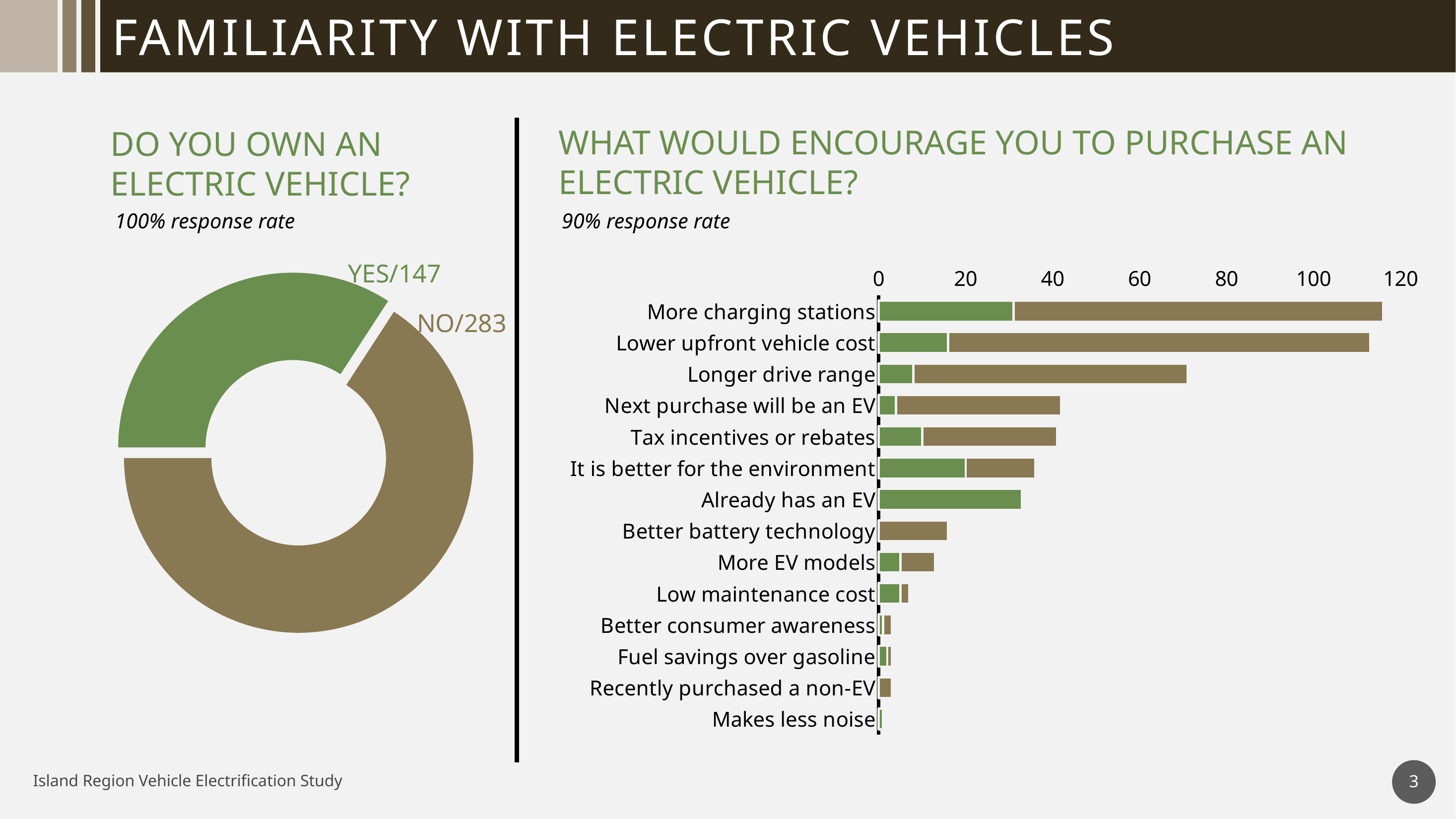
In the 'Do you own an electric vehicle?' chart, what is the difference between the NO and YES counts? 136 In the 'What would encourage you to purchase an electric vehicle?' chart, which bar is longer: 'More charging stations' or 'Longer drive range'? More charging stations What kind of chart is the 'Do you own an electric vehicle?' chart? Donut chart In the 'What would encourage you to purchase an electric vehicle?' chart, how many categories are listed? 14 In the 'What would encourage you to purchase an electric vehicle?' chart, which category has the longest bar? More charging stations In the 'What would encourage you to purchase an electric vehicle?' chart, which category has the shortest bar? Makes less noise In the 'Do you own an electric vehicle?' chart, which answer has the larger count? NO In the 'Do you own an electric vehicle?' chart, how many respondents answered YES? 147 In the 'What would encourage you to purchase an electric vehicle?' chart, is the total bar length for 'Better battery technology' greater or less than 20? less In the 'What would encourage you to purchase an electric vehicle?' chart, is the total bar length for 'Lower upfront vehicle cost' greater or less than 100? greater In the 'Do you own an electric vehicle?' chart, how many respondents answered NO? 283 What kind of chart is the 'What would encourage you to purchase an electric vehicle?' chart? Bar chart